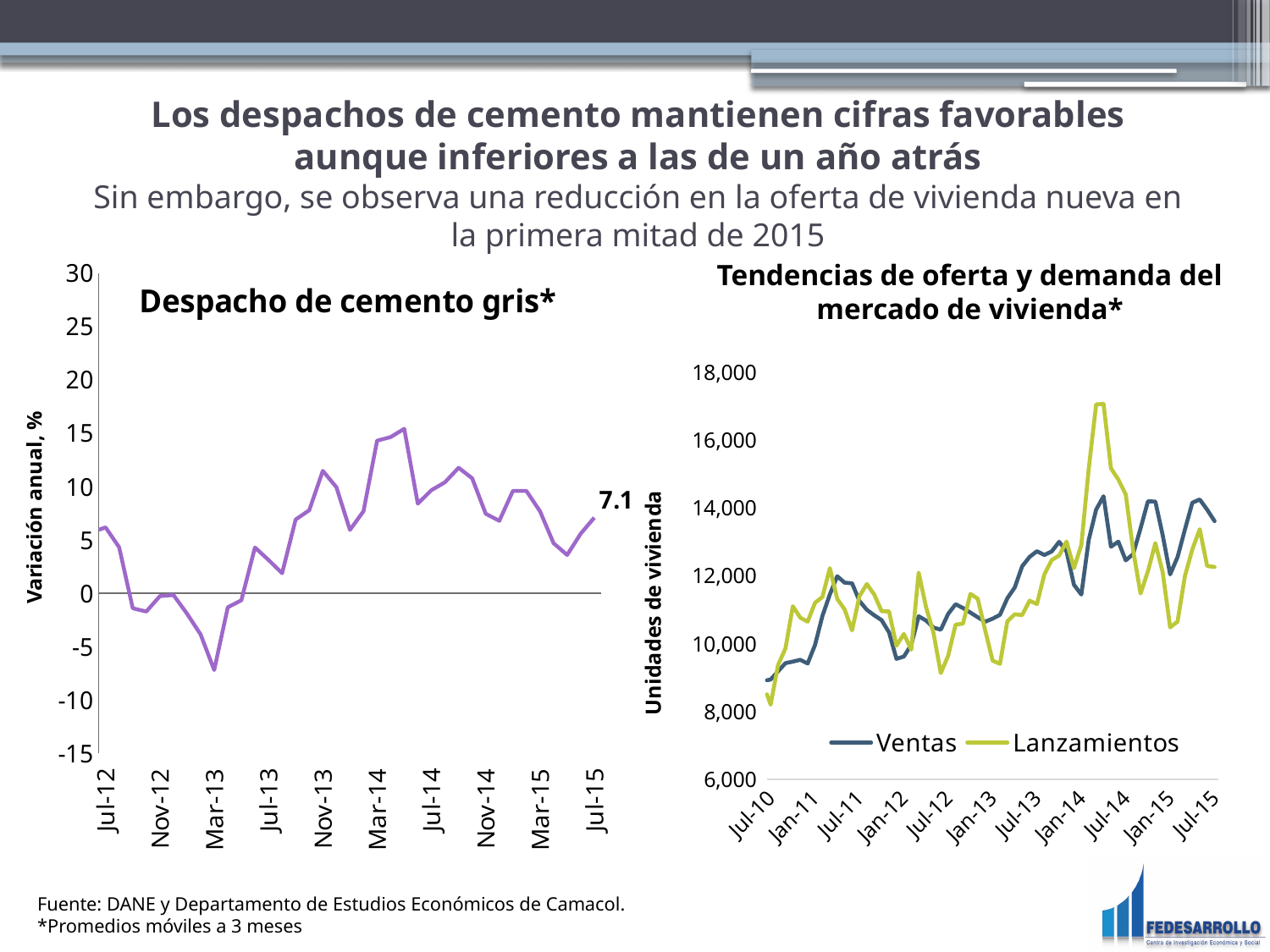
In the 'Tendencias de oferta y demanda del mercado de vivienda*' chart, which series reaches the higher peak, Ventas or Lanzamientos? Lanzamientos In the 'Despacho de cemento gris*' chart, what is the label of the vertical axis? Variación anual, % In the 'Tendencias de oferta y demanda del mercado de vivienda*' chart, is the Ventas value at Jul-10 greater or less than 10,000? less In the 'Despacho de cemento gris*' chart, is the value for Jul-13 greater or less than 5? less In the 'Tendencias de oferta y demanda del mercado de vivienda*' chart, is the peak value of Lanzamientos around Jul-14 greater or less than 16,000? greater What are the two series named in the legend of the 'Tendencias de oferta y demanda del mercado de vivienda*' chart? Ventas and Lanzamientos How many series does the legend list in the 'Tendencias de oferta y demanda del mercado de vivienda*' chart? 2 In the 'Despacho de cemento gris*' chart, what value is labeled at the end of the line for Jul-15? 7.1 What kind of chart is the 'Tendencias de oferta y demanda del mercado de vivienda*' chart on the right? line chart What kind of chart is the 'Despacho de cemento gris*' chart on the left? line chart